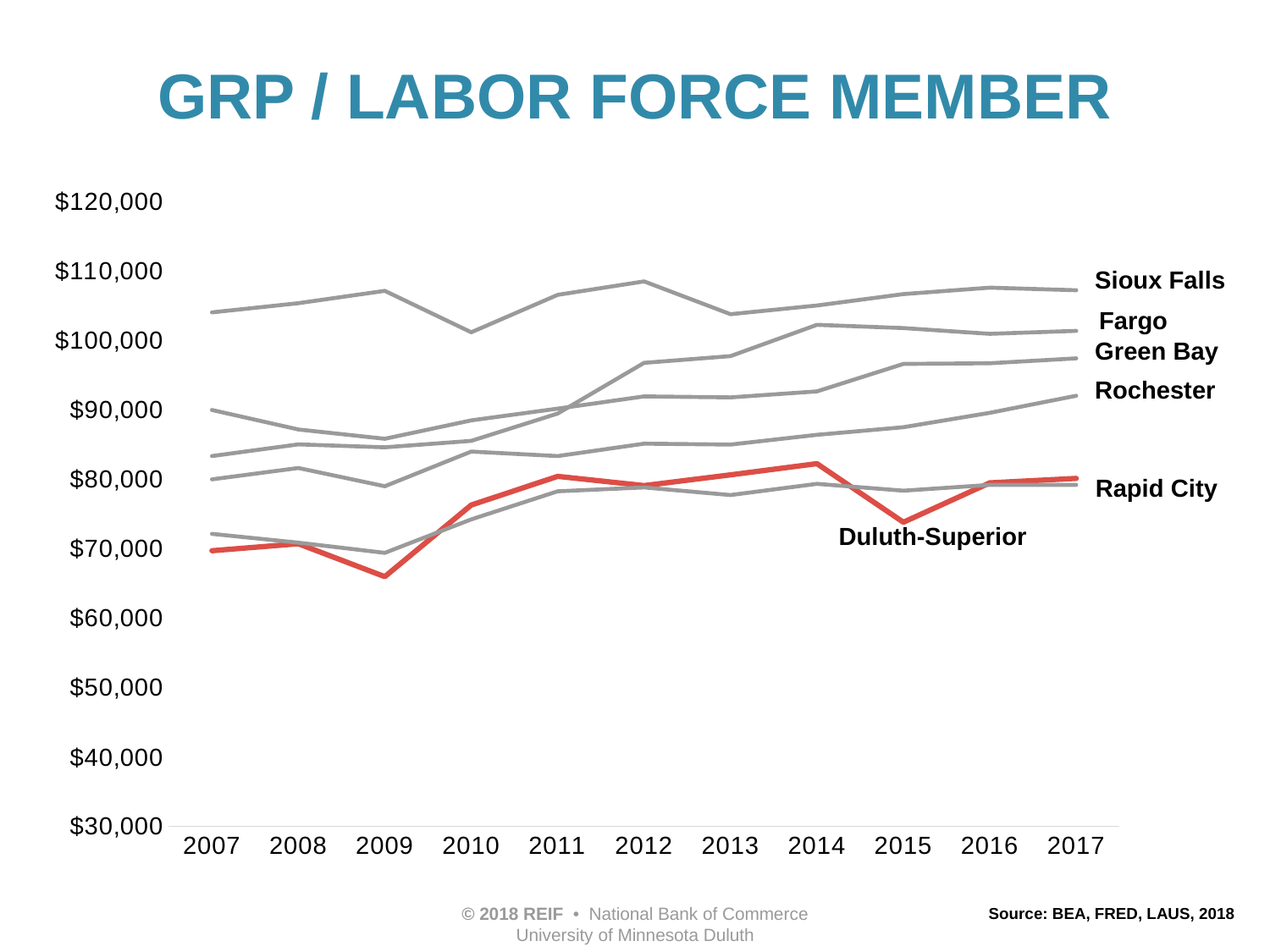
How many years are plotted along the x axis? 11 Is the value for Duluth-Superior in 2015 greater or less than $80,000? less Does the Rochester line rise or fall from 2007 to 2017? rise Is the value for Sioux Falls in 2017 greater or less than $100,000? greater Which metro area's line is drawn in red? Duluth-Superior Which metro area has the highest GRP per labor force member in 2017? Sioux Falls In 2012, which is higher: Sioux Falls or Green Bay? Sioux Falls What kind of chart is shown on the slide? line chart Which metro area has the lowest GRP per labor force member in 2009? Duluth-Superior How many metro areas (series) are labelled on the chart? 6 Is the value for Duluth-Superior in 2009 greater or less than $70,000? less In 2015, which is higher: Rapid City or Duluth-Superior? Rapid City